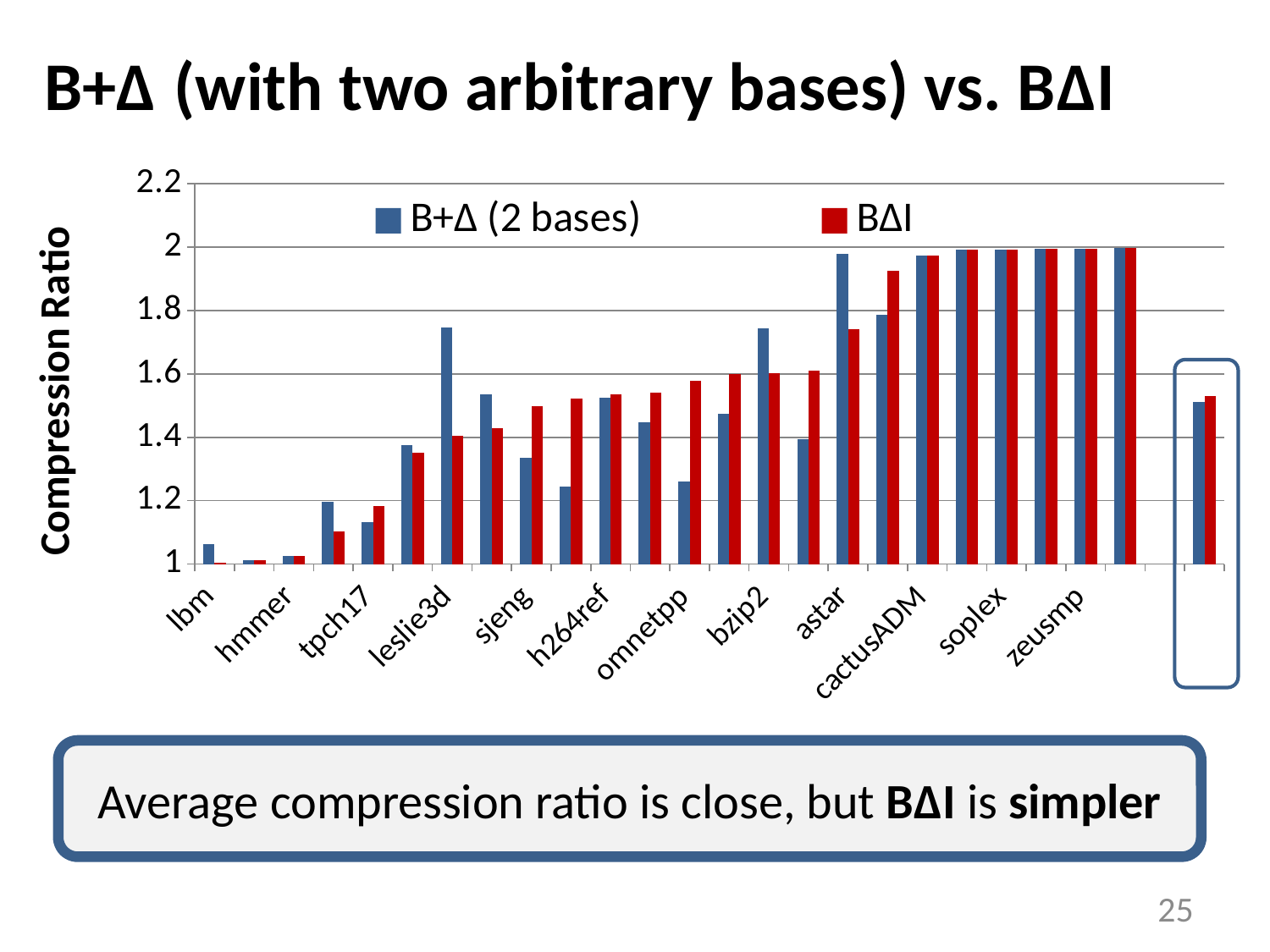
Is the BΔI value for omnetpp greater or less than 1.4? greater For astar, which series has the larger value, B+Δ (2 bases) or BΔI? B+Δ (2 bases) For omnetpp, which series has the larger value, B+Δ (2 bases) or BΔI? BΔI Is the B+Δ (2 bases) value for omnetpp greater or less than 1.4? less Is the BΔI value for astar greater or less than 1.6? greater What is the label of the vertical axis? Compression Ratio How many series does the legend list? 2 What are the two series named in the legend? B+Δ (2 bases) and BΔI What kind of chart is shown on the slide? bar chart For leslie3d, which series has the larger value, B+Δ (2 bases) or BΔI? B+Δ (2 bases)